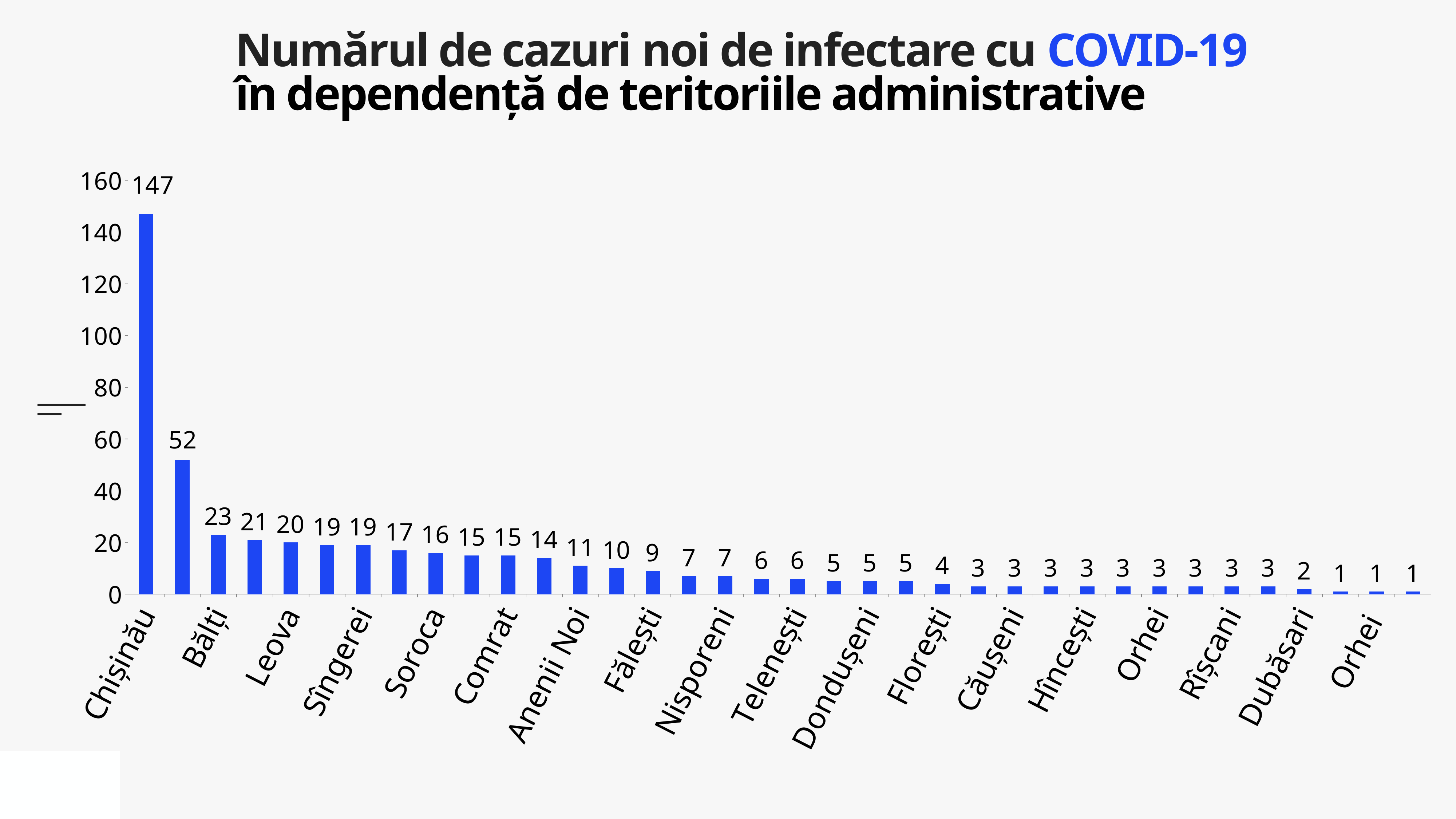
How many bars have a value of 1? 3 What is the difference between the tallest bar (147) and the second-tallest bar (52)? 95 What kind of chart is shown? bar chart What is the highest tick value on the vertical axis? 160 How many bars are plotted on the chart? 36 Which category has the highest value? Chișinău Do the values rise or fall from left to right along the x axis? fall What is the value for Chișinău? 147 What colour are the bars? blue Is the value for Chișinău greater or less than 140? greater What is the lowest value shown on the chart? 1 What is the value of the second-tallest bar? 52